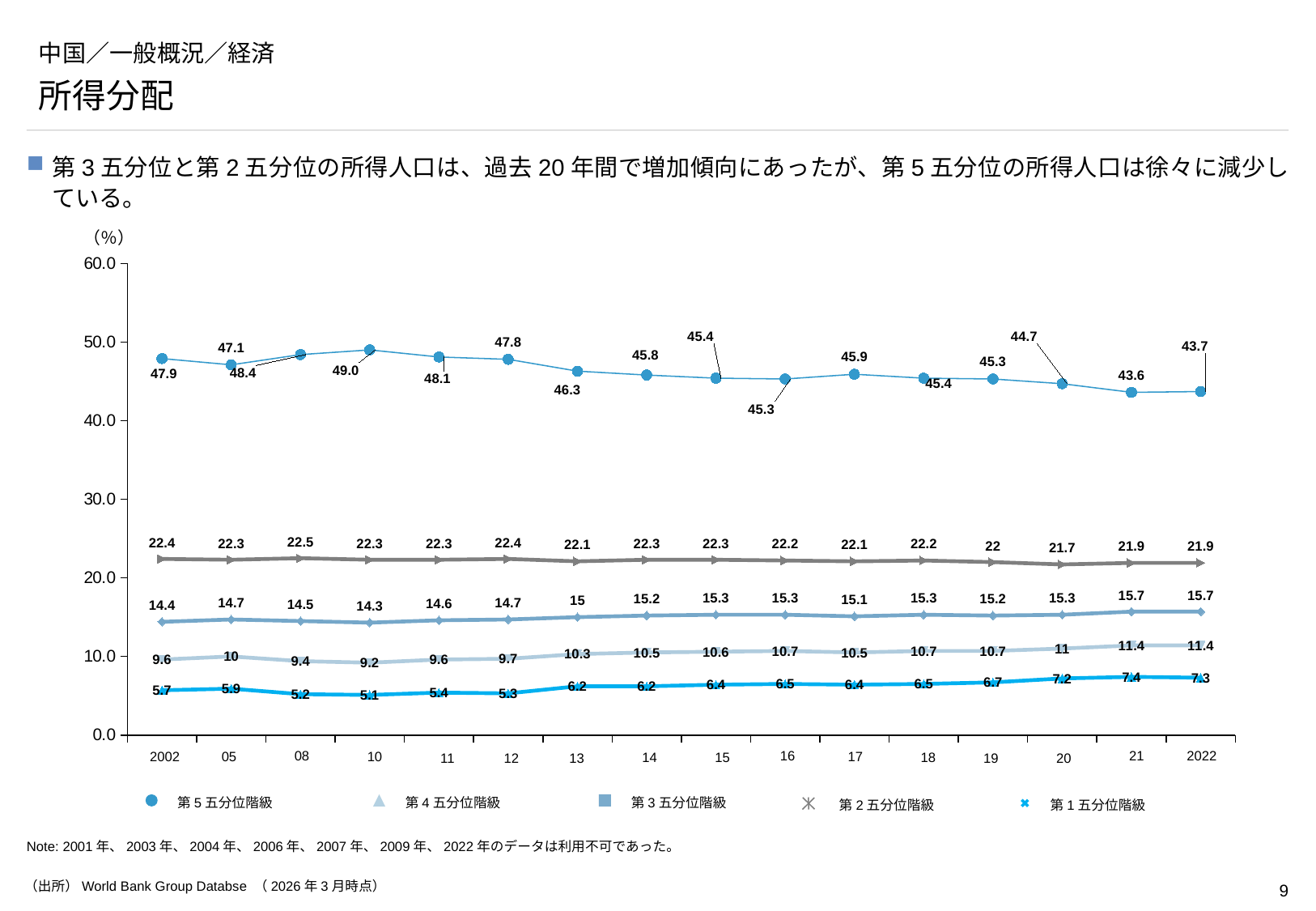
How many years are plotted on the x axis? 16 Which is larger in 2022: the value for 第4五分位階級 or 第3五分位階級? 第4五分位階級 What is the difference between the 第5五分位階級 values in 2002 and 2022? 4.2 What is the value for 第1五分位階級 in 2022? 7.3 What is the value for 第2五分位階級 in 2010? 9.2 In which year does 第5五分位階級 reach its highest value? 2010 Does the value for 第5五分位階級 generally rise or fall from 2010 to 2022? Fall What is the value for 第5五分位階級 in 2002? 47.9 What kind of chart is shown on the slide? Line chart In which year is the value for 第1五分位階級 lowest? 2010 What is the value for 第3五分位階級 in 2021? 15.7 How many series does the legend list? 5